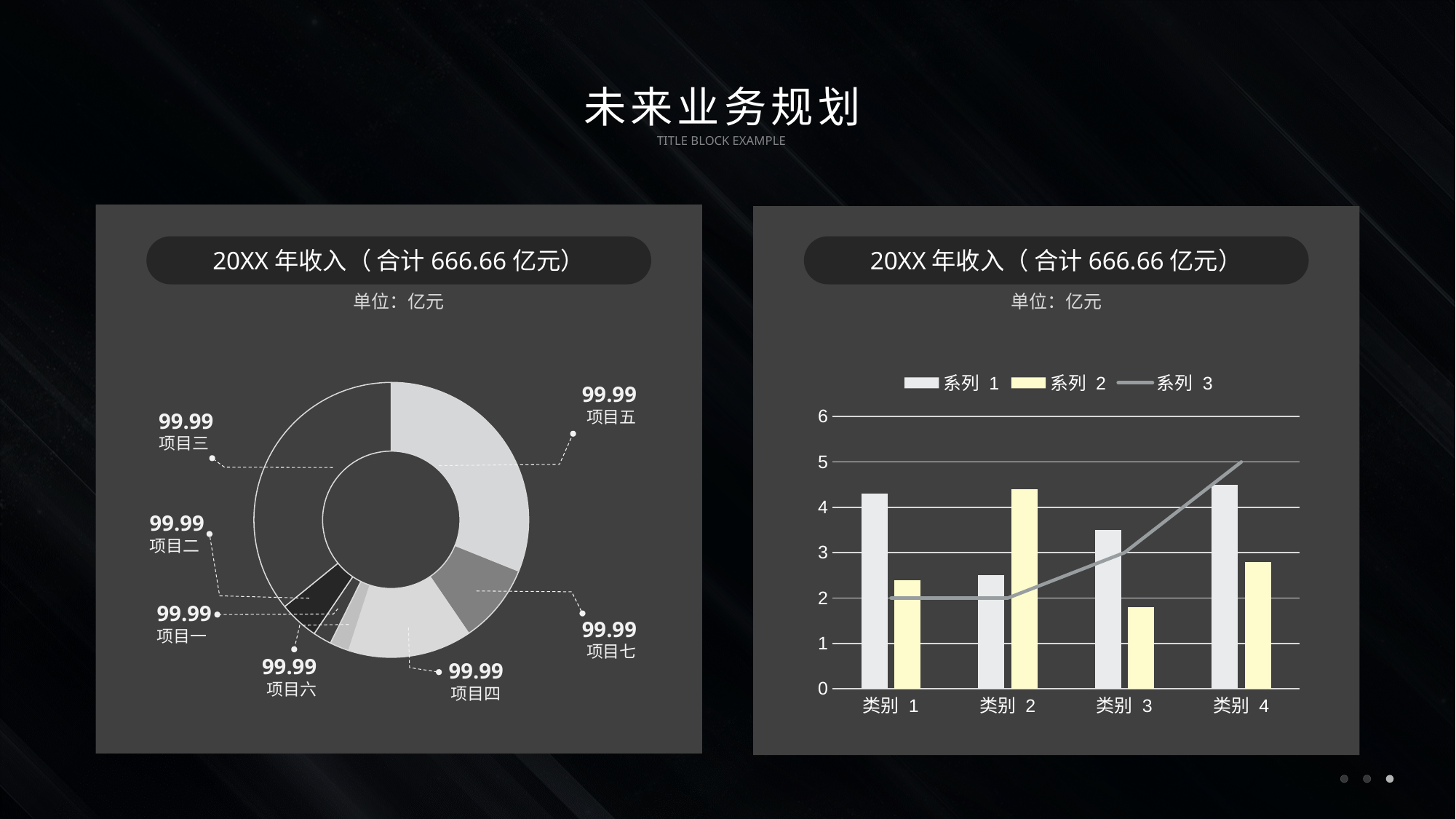
On the right chart, does the 系列 3 line rise or fall from 类别 2 to 类别 4? rise How many categories (项目) are labelled on the left doughnut chart? 7 How many series does the legend of the right chart list? 3 On the left chart, what value is shown for 项目五? 99.99 On the right chart, is the 系列 1 value for 类别 1 greater or less than 4? greater What unit is stated below the title of the left chart? 亿元 On the right chart, which category has the highest 系列 2 value? 类别 2 What kind of chart is the left chart? Doughnut chart On the left chart, what value is shown for 项目三? 99.99 How many categories are on the x axis of the right chart? 4 On the right chart, which category has the lowest 系列 2 value? 类别 3 On the right chart, is the 系列 2 value for 类别 3 greater or less than 2? less